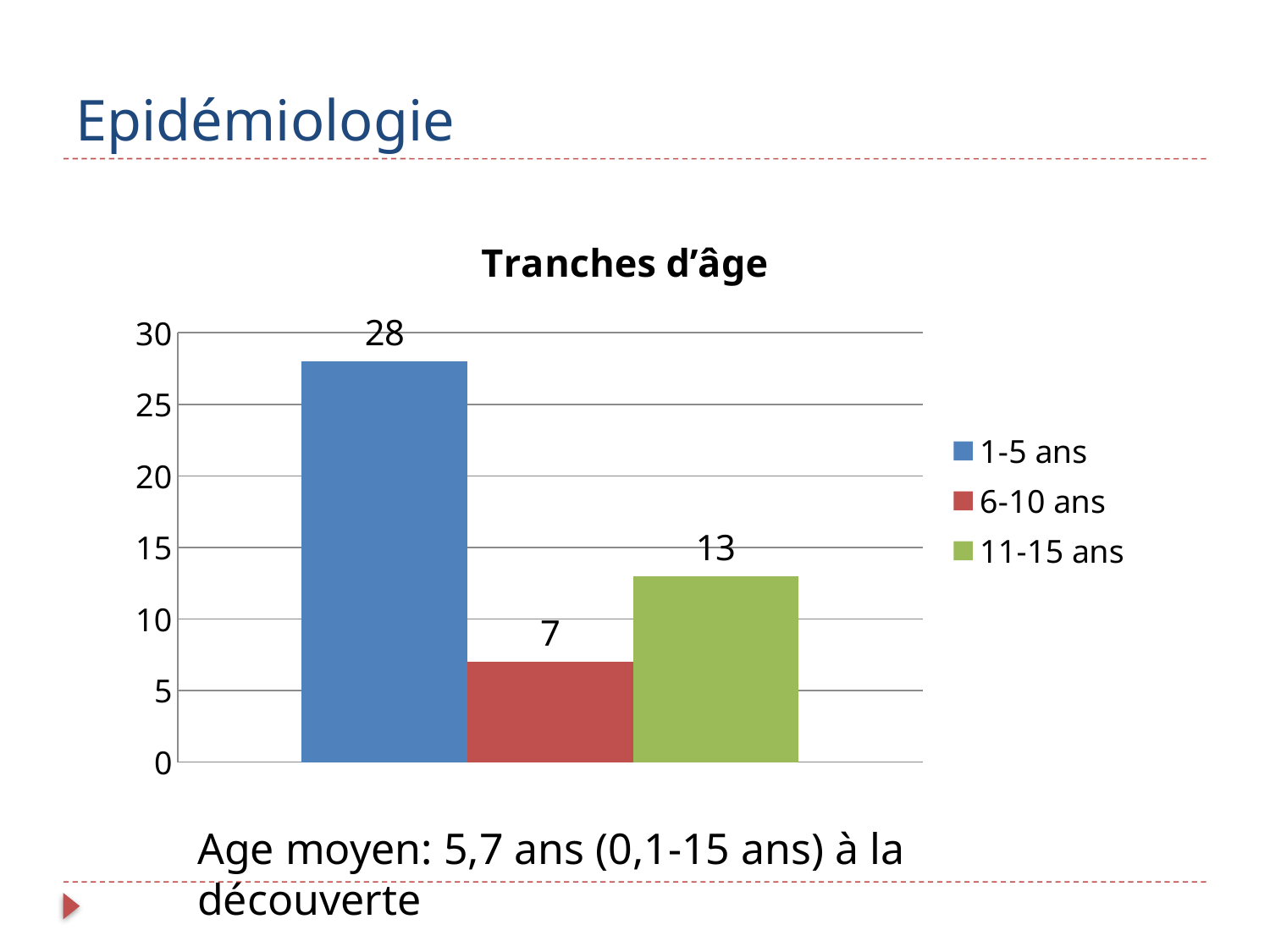
Which is larger, the value for 6-10 ans or the value for 11-15 ans? 11-15 ans What is the difference between the values for 11-15 ans and 6-10 ans? 6 What kind of chart is shown on the slide? bar chart Is the value for 1-5 ans greater or less than 25? greater What is the title of the chart? Tranches d'âge Which age group has the lowest value? 6-10 ans What is the value for 11-15 ans? 13 Which age group has the highest value? 1-5 ans What is the value for 6-10 ans? 7 What is the difference between the values for 1-5 ans and 11-15 ans? 15 What is the value for 1-5 ans? 28 How many series does the legend list? 3